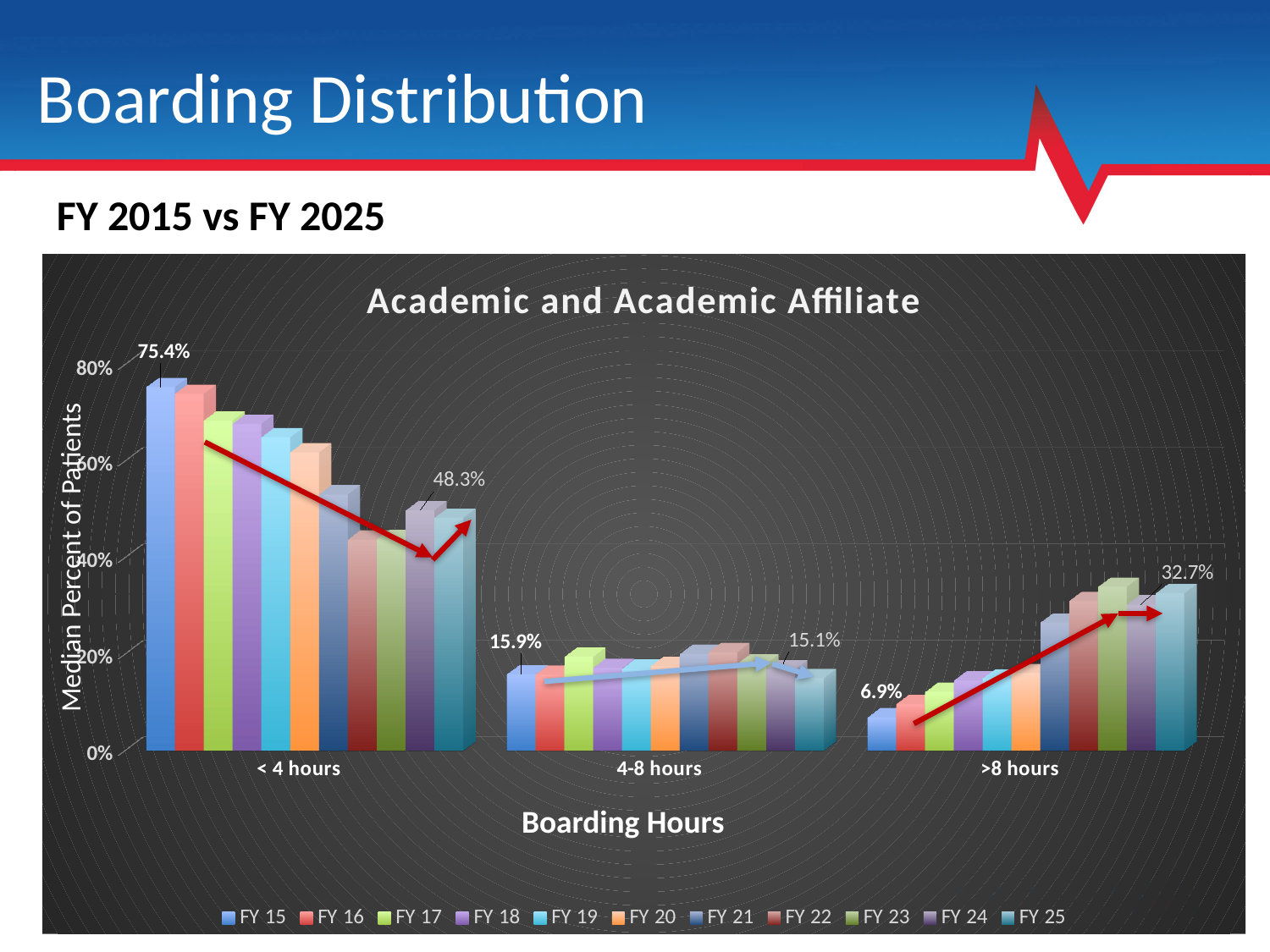
What is the value for FY 25 in the >8 hours category? 32.7% What is the value for FY 15 in the < 4 hours category? 75.4% How many series does the legend list? 11 By how many percentage points does the FY 15 value exceed the FY 25 value in the < 4 hours category? 27.1 percentage points What kind of chart is shown on the slide? Bar chart How many boarding-hour categories are shown on the x axis? 3 What is the value for FY 15 in the 4-8 hours category? 15.9% In the 4-8 hours category, which is larger: the FY 15 value or the FY 25 value? FY 15 What is the value for FY 25 in the < 4 hours category? 48.3% What is the value for FY 15 in the >8 hours category? 6.9% By how many percentage points does the FY 25 value exceed the FY 15 value in the >8 hours category? 25.8 percentage points Is the value for FY 23 in the >8 hours category greater or less than 20%? greater